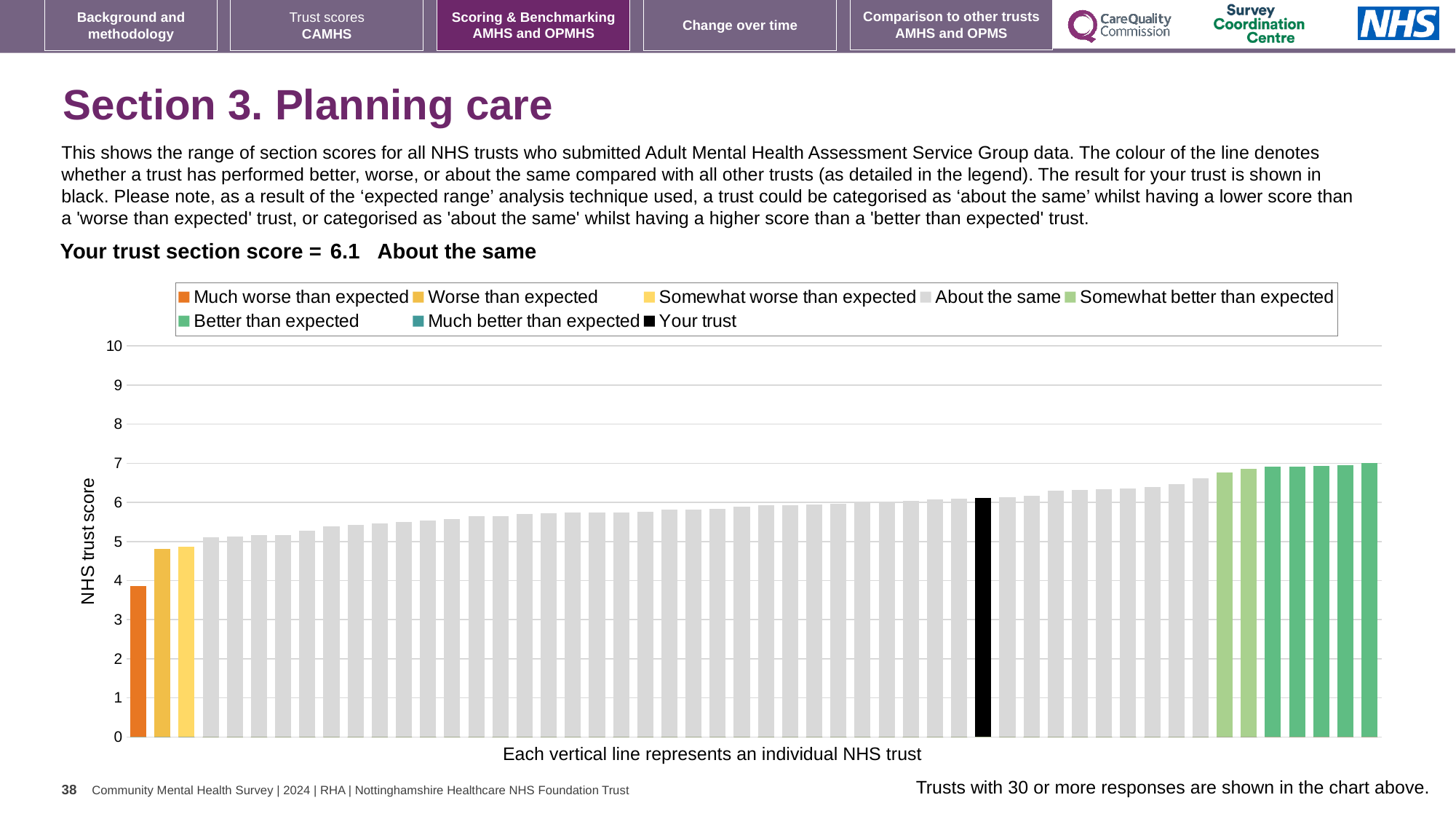
Do the bar values rise or fall from left to right along the x axis? rise What colour is the bar representing your trust? black Which legend category does the lowest bar on the chart belong to? Much worse than expected What kind of chart is shown on the slide? bar chart What is the label on the y axis of the chart? NHS trust score How many entries does the chart legend list? 8 Is the value of the highest bar greater or less than 8? less How is your trust categorised compared with other trusts in this section? About the same How many bars are coloured orange (Much worse than expected)? 1 What is your trust's section score for Planning care? 6.1 Is the value for your trust (the black bar) greater or less than 5? greater Is the value of the lowest bar (the orange bar) greater or less than 5? less